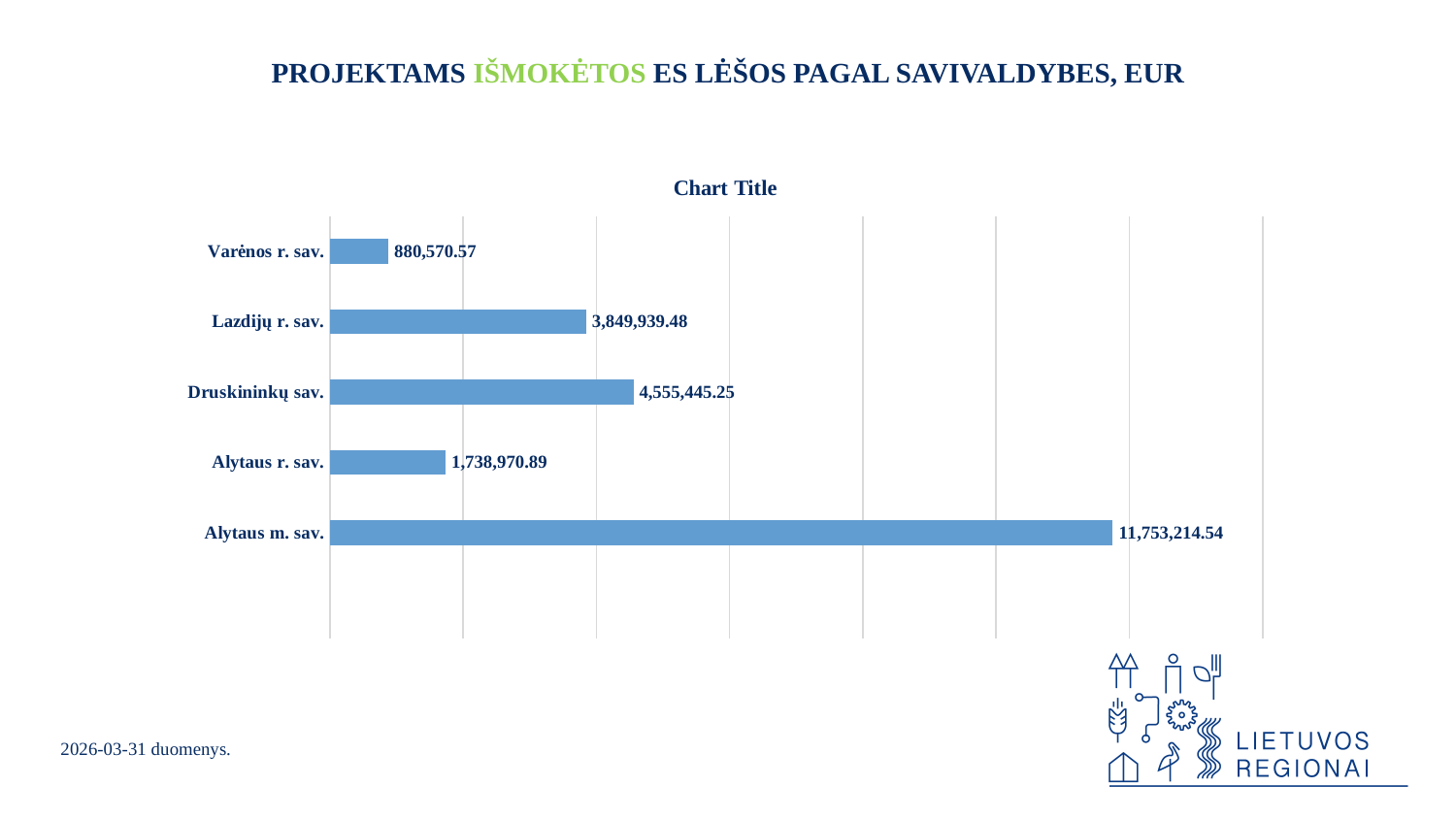
Which municipality has the highest value? Alytaus m. sav. What kind of chart is shown on the slide? Bar chart What is the value for Druskininkų sav.? 4,555,445.25 Which municipality has the lowest value? Varėnos r. sav. What is the value for Lazdijų r. sav.? 3,849,939.48 What is the difference between the values for Alytaus r. sav. and Varėnos r. sav.? 858,400.32 How many municipalities are shown in the chart? 5 What is the title printed above the chart? Chart Title What is the value for Varėnos r. sav.? 880,570.57 What is the difference between the values for Druskininkų sav. and Lazdijų r. sav.? 705,505.77 Which is larger, the value for Alytaus r. sav. or the value for Lazdijų r. sav.? Lazdijų r. sav. What is the value for Alytaus m. sav.? 11,753,214.54